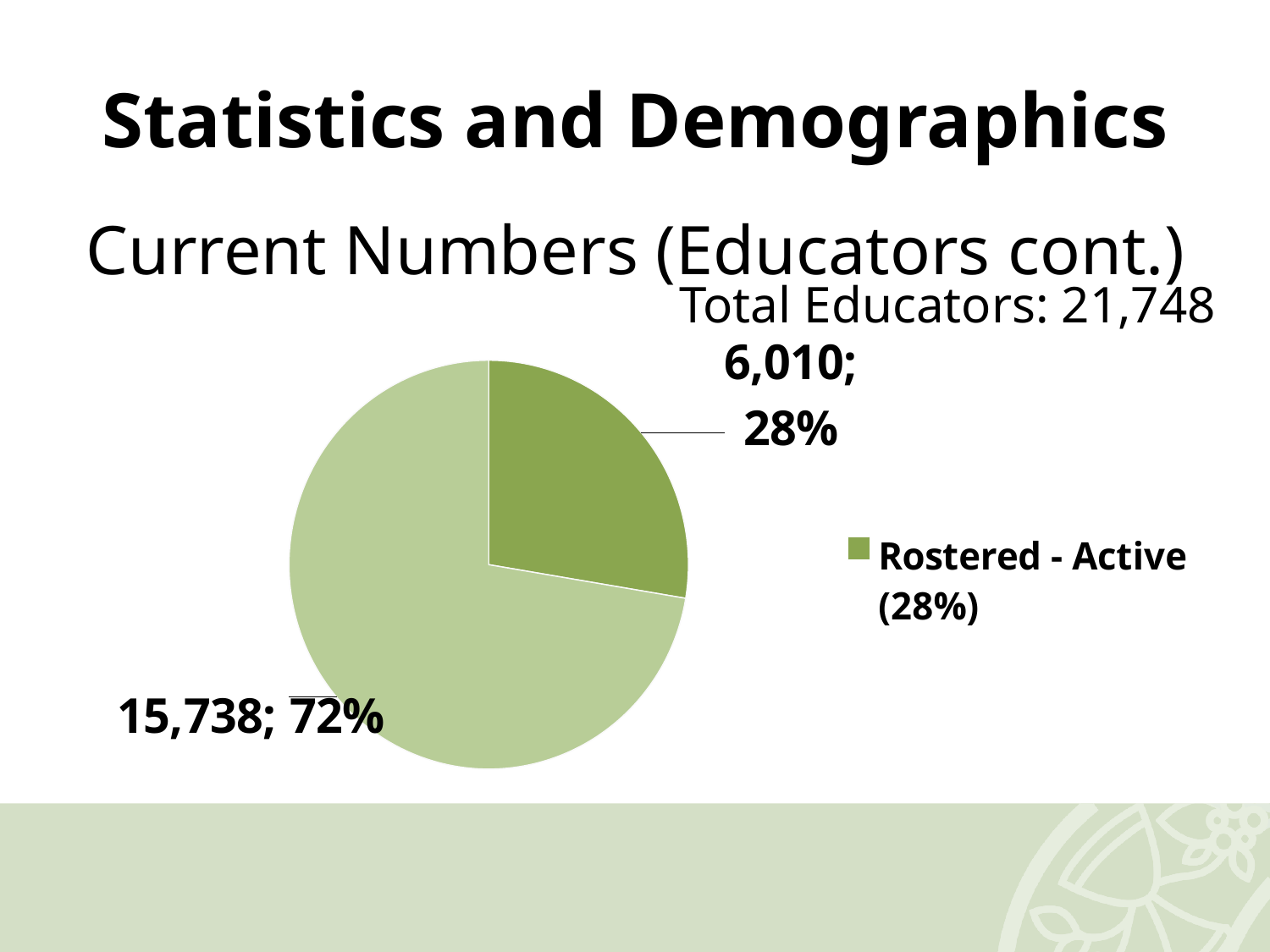
Is the Rostered - Active slice larger or smaller than the other slice? smaller What is the total of the two slice values shown on the pie chart? 21,748 What kind of chart is shown on the slide? pie chart What is the difference between the value of the larger slice (15,738) and the Rostered - Active slice (6,010)? 9,728 What value is shown on the larger slice of the pie chart? 15,738 What is the value shown for the Rostered - Active slice? 6,010 What total number of educators is stated above the pie chart? 21,748 How many entries does the legend of the pie chart list? 1 Which colour is used for the Rostered - Active slice in the legend? dark green What share of the pie does the Rostered - Active slice represent? 28% How many slices does the pie chart have? 2 What percentage is shown on the larger slice of the pie chart? 72%